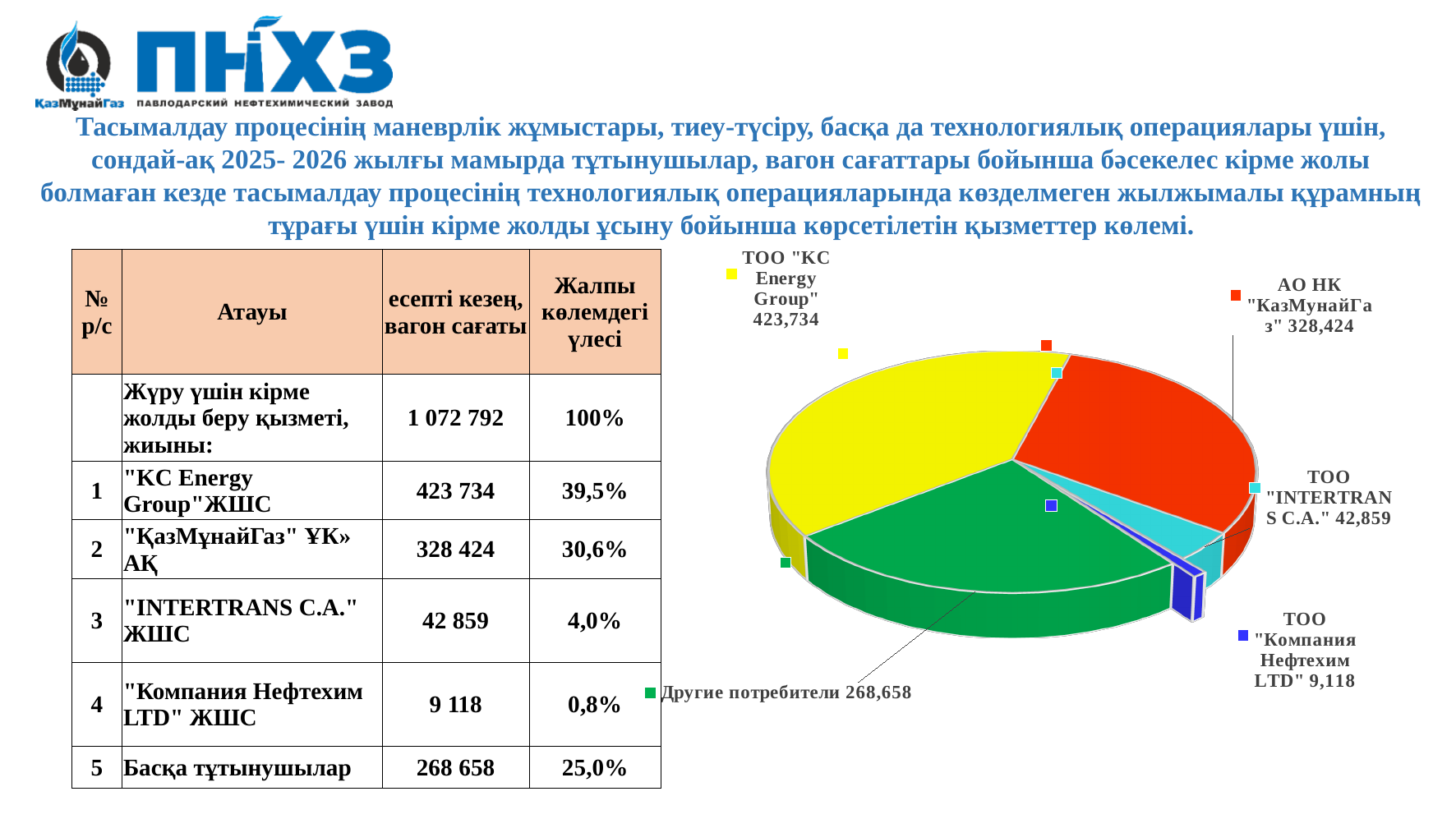
What value is shown for АО НК "КазМунайГаз" in the pie chart? 328,424 Which is larger in the pie chart: ТОО "INTERTRANS C.A." or ТОО "Компания Нефтехим LTD"? ТОО "INTERTRANS C.A." What value is shown for ТОО "KC Energy Group" in the pie chart? 423,734 What value is shown for ТОО "Компания Нефтехим LTD" in the pie chart? 9,118 What value is shown for Другие потребители in the pie chart? 268,658 What colour is the slice for ТОО "KC Energy Group" in the pie chart? Yellow What value is shown for ТОО "INTERTRANS C.A." in the pie chart? 42,859 What kind of chart is shown on the slide? Pie chart What is the difference between the values for ТОО "KC Energy Group" and АО НК "КазМунайГаз" in the pie chart? 95,310 How many slices does the pie chart have? 5 Which slice of the pie chart has the smallest value? ТОО "Компания Нефтехим LTD" Which slice of the pie chart has the largest value? ТОО "KC Energy Group"